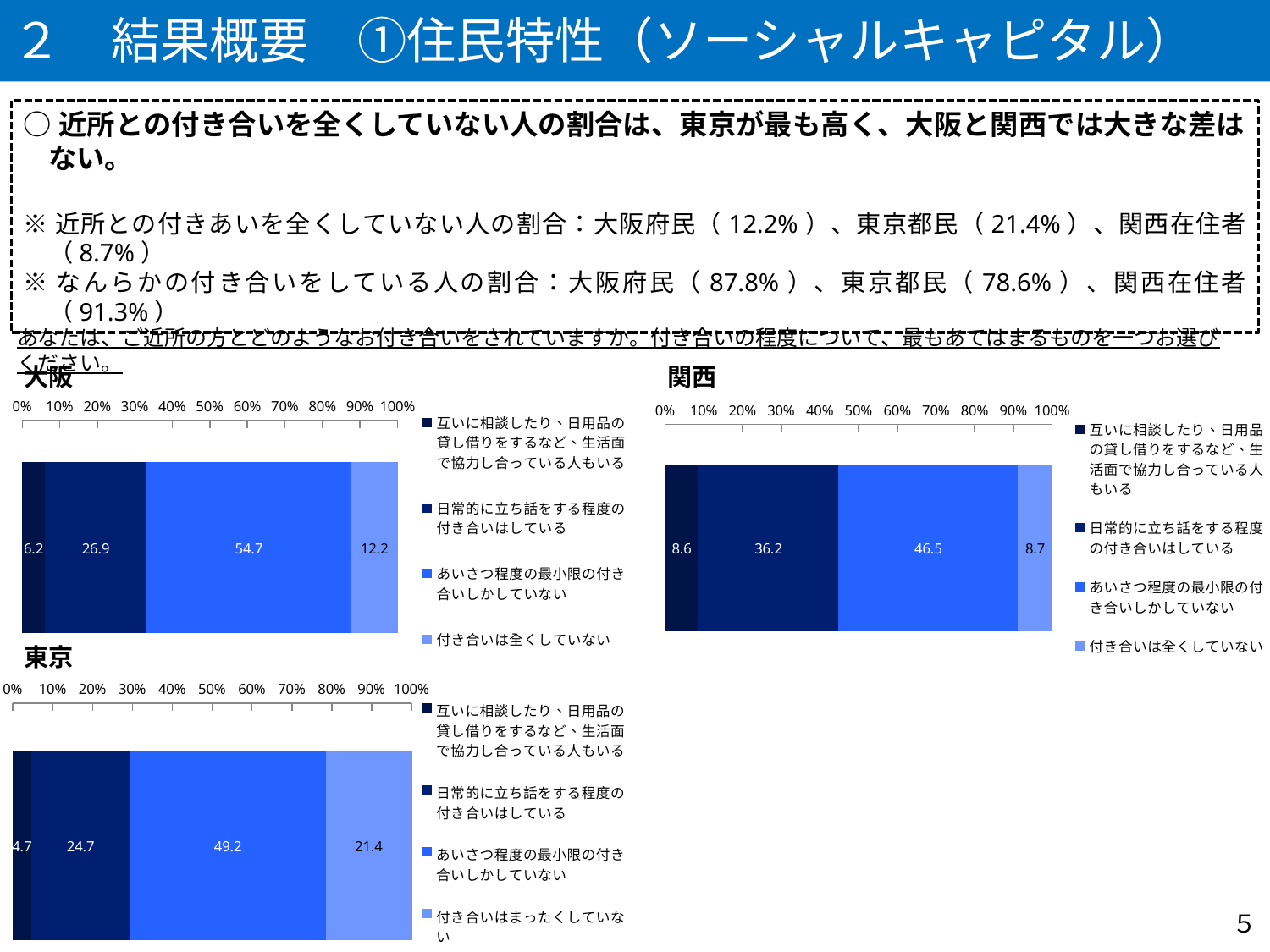
「大阪」のグラフで、「あいさつ程度の最小限の付き合いしかしていない」の値はいくつですか。 54.7 「関西」のグラフで、「日常的に立ち話をする程度の付き合いはしている」の値はいくつですか。 36.2 「東京」のグラフで、最も値が小さい区分はどれですか。 互いに相談したり、日用品の貸し借りをするなど、生活面で協力し合っている人もいる 「東京」のグラフで、「日常的に立ち話をする程度の付き合いはしている」と「あいさつ程度の最小限の付き合いしかしていない」の合計はいくつですか。 73.9 「関西」のグラフで、「あいさつ程度の最小限の付き合いしかしていない」と「日常的に立ち話をする程度の付き合いはしている」ではどちらが大きいですか。 あいさつ程度の最小限の付き合いしかしていない 「東京」のグラフで、「付き合いはまったくしていない」の値はいくつですか。 21.4 「東京」のグラフで、「あいさつ程度の最小限の付き合いしかしていない」の値は50%より大きいですか、小さいですか。 小さい 「関西」のグラフで、「互いに相談したり、日用品の貸し借りをするなど、生活面で協力し合っている人もいる」の値はいくつですか。 8.6 「大阪」のグラフで、最も値が大きい区分はどれですか。 あいさつ程度の最小限の付き合いしかしていない 「大阪」のグラフの凡例には、いくつの系列が示されていますか。 4 「関西」のグラフはどのような種類のグラフですか。 積み上げ棒グラフ 「大阪」のグラフで、「日常的に立ち話をする程度の付き合いはしている」と「付き合いは全くしていない」の差はいくつですか。 14.7